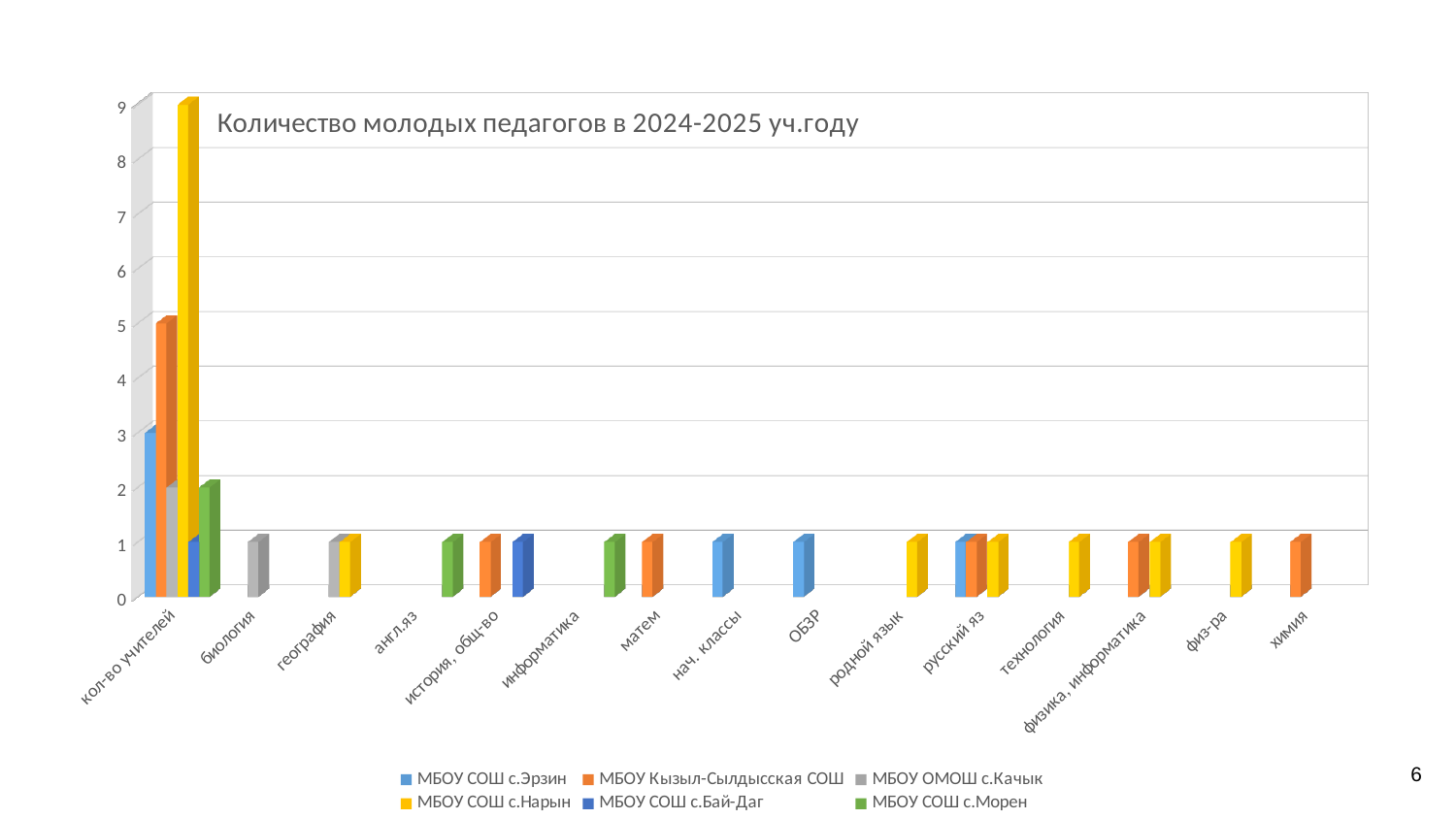
Which category has the tallest bar in the whole chart? кол-во учителей In the category 'кол-во учителей', which is larger: the value for МБОУ Кызыл-Сылдысская СОШ or for МБОУ ОМОШ с.Качык? МБОУ Кызыл-Сылдысская СОШ Is the value for МБОУ СОШ с.Нарын in the category 'кол-во учителей' greater or less than 8? greater What kind of chart is shown on the slide? bar chart Is the value for МБОУ СОШ с.Эрзин in the category 'кол-во учителей' greater or less than 2? greater In the category 'кол-во учителей', which school has the highest bar? МБОУ СОШ с.Нарын Is the value for МБОУ Кызыл-Сылдысская СОШ in the category 'кол-во учителей' greater or less than 4? greater Which school is the only one with a bar in the category 'биология'? МБОУ ОМОШ с.Качык In the category 'кол-во учителей', which is larger: the value for МБОУ СОШ с.Эрзин or for МБОУ СОШ с.Бай-Даг? МБОУ СОШ с.Эрзин How many series does the legend list? 6 How many categories are shown along the x axis? 15 What is the title of the chart? Количество молодых педагогов в 2024-2025 уч.году